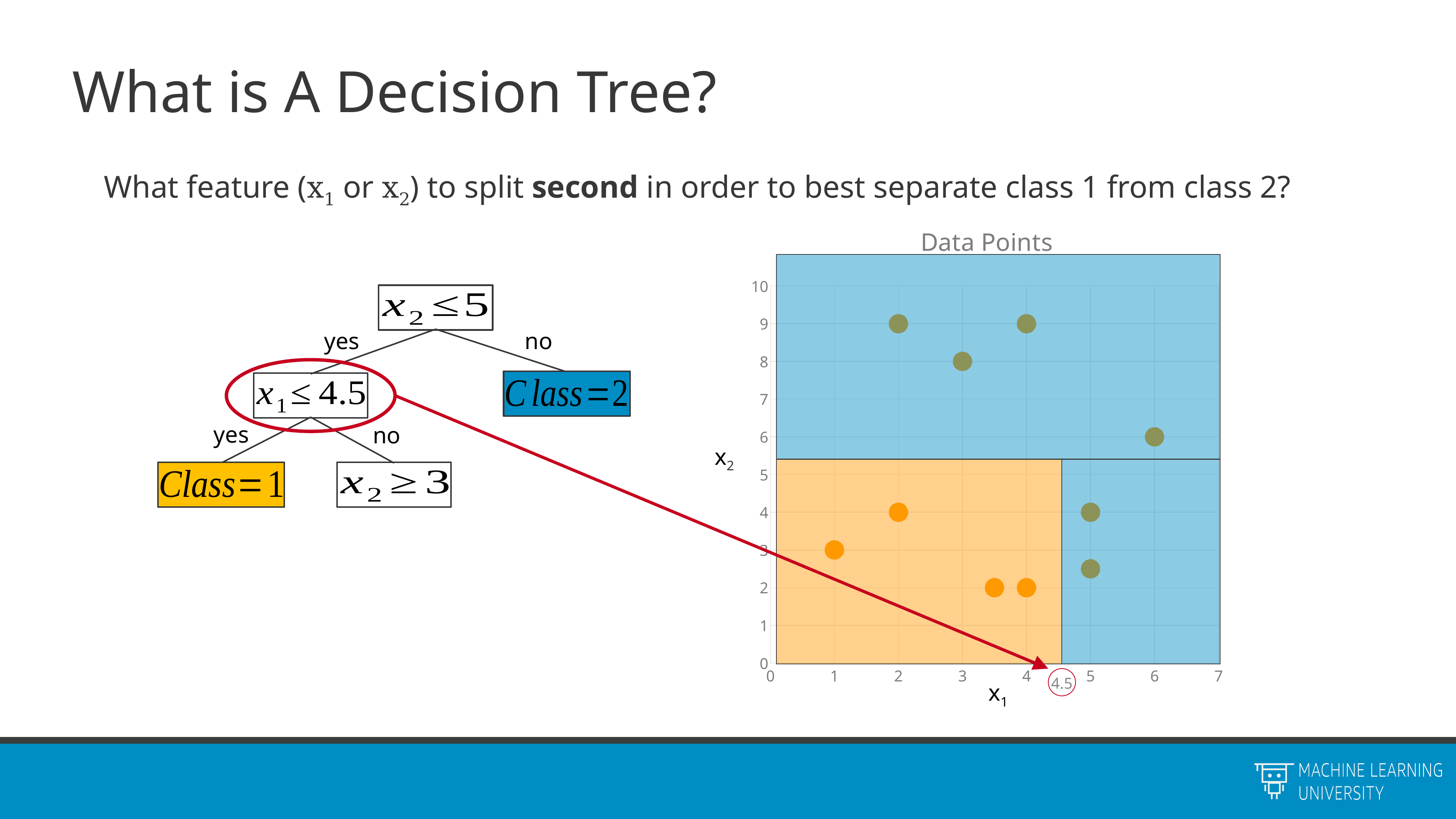
How many olive-green points are plotted in the "Data Points" chart? 6 In the "Data Points" chart, what is the highest x2 value reached by any point? 9 What is the title of the chart on the slide? Data Points How many data points are plotted in the "Data Points" chart? 10 In the "Data Points" chart, what is the x1 value of the point plotted at x2 = 8? 3 In the "Data Points" chart, is the x2 value of the rightmost point greater or less than 5? greater In the "Data Points" chart, what is the lowest x2 value reached by any point? 2 How many orange points are plotted in the "Data Points" chart? 4 What value is circled in red on the x1 axis of the "Data Points" chart? 4.5 In the "Data Points" chart, what is the x1 value of the point plotted at x2 = 6? 6 What kind of chart is the "Data Points" chart? scatter chart In the "Data Points" chart, which point has the larger x1 value: the point at x2 = 6 or the point at x2 = 8? the point at x2 = 6